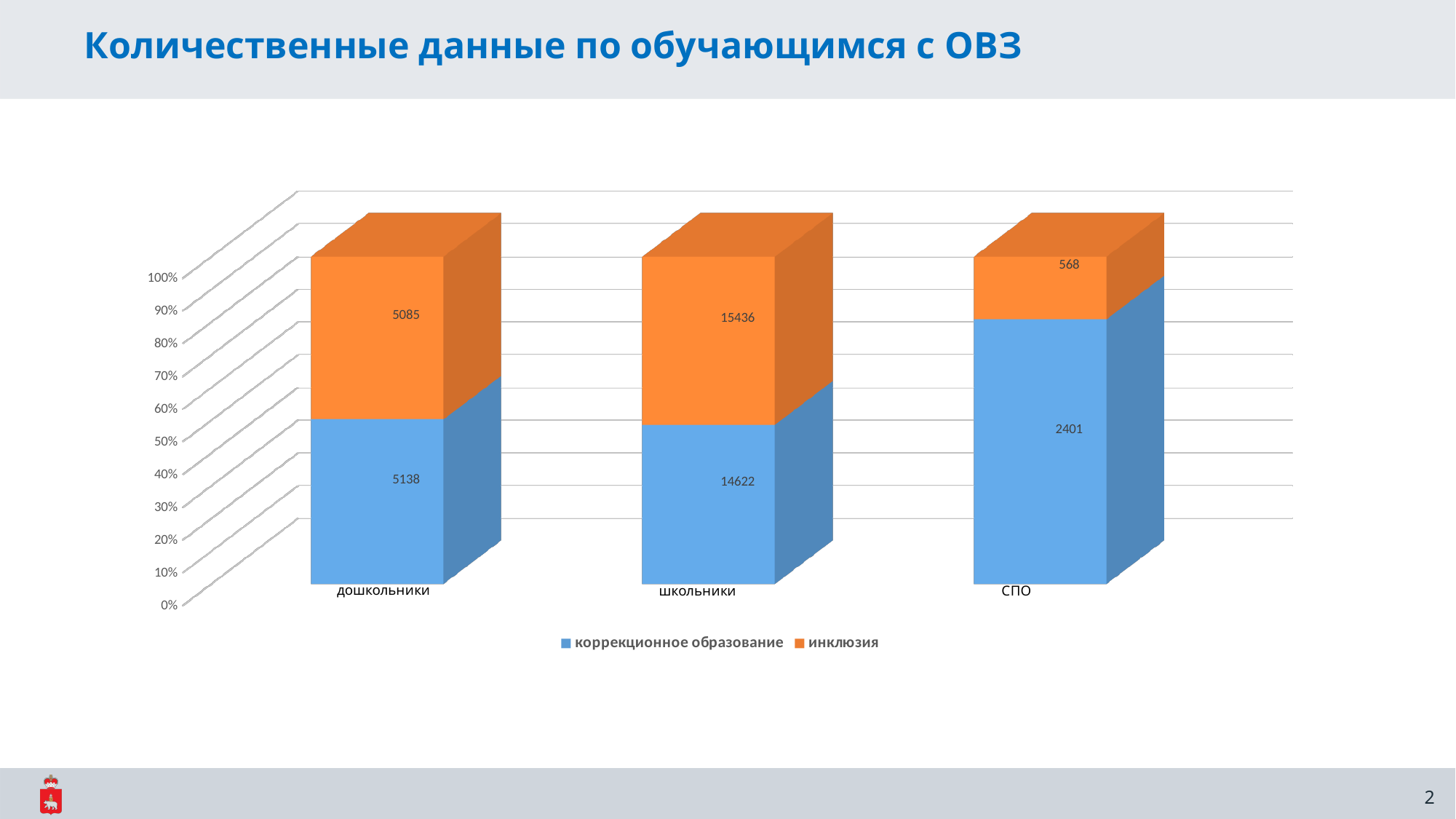
How many categories are shown on the x axis? 3 How many series does the legend list? 2 Which category has the lowest value for коррекционное образование? СПО What is the total of the stacked bar for СПО? 2969 For дошкольники, which is larger: коррекционное образование or инклюзия? коррекционное образование What is the value for коррекционное образование for школьники? 14622 What is the difference between инклюзия and коррекционное образование for школьники? 814 What is the value for инклюзия for дошкольники? 5085 Which category has the highest value for инклюзия? школьники What is the difference between коррекционное образование and инклюзия for СПО? 1833 What is the value for коррекционное образование for СПО? 2401 What is the value for инклюзия for СПО? 568